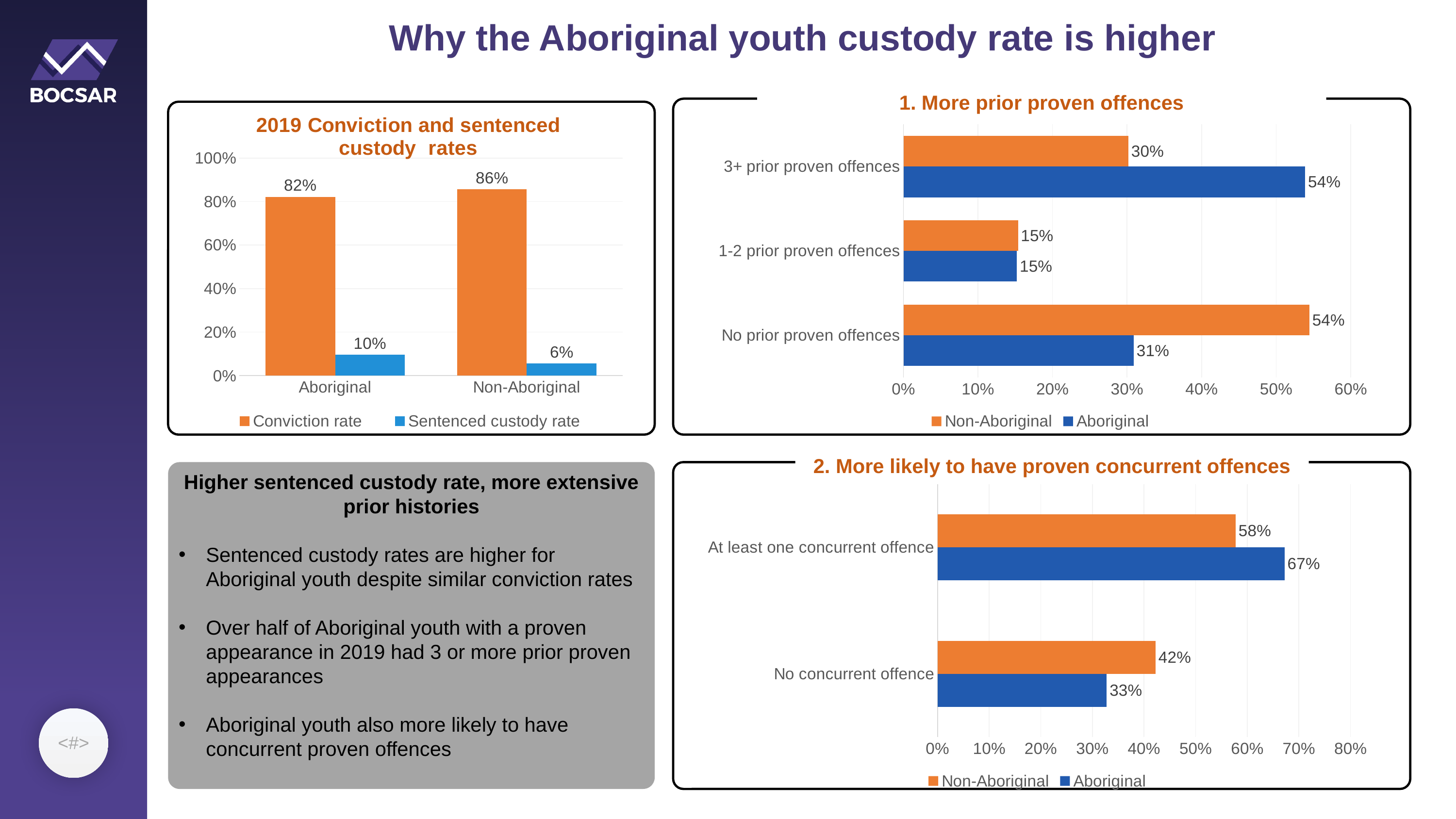
In the '1. More prior proven offences' chart, what is the Non-Aboriginal value for No prior proven offences? 54% In the '1. More prior proven offences' chart, what is the Aboriginal value for 3+ prior proven offences? 54% In the '2019 Conviction and sentenced custody rates' chart, what is the sentenced custody rate for Non-Aboriginal youth? 6% In the '2019 Conviction and sentenced custody rates' chart, what is the conviction rate for Aboriginal youth? 82% In the '2. More likely to have proven concurrent offences' chart, what is the difference between the Non-Aboriginal and Aboriginal values for No concurrent offence? 9% In the '2. More likely to have proven concurrent offences' chart, what is the Aboriginal value for At least one concurrent offence? 67% In the '2. More likely to have proven concurrent offences' chart, which colour represents Non-Aboriginal? Orange In the '1. More prior proven offences' chart, which group has the larger value for 3+ prior proven offences, Aboriginal or Non-Aboriginal? Aboriginal In the '2019 Conviction and sentenced custody rates' chart, what is the difference between the Aboriginal and Non-Aboriginal sentenced custody rates? 4% In the '2019 Conviction and sentenced custody rates' chart, how many series does the legend list? 2 What kind of chart is '2. More likely to have proven concurrent offences'? Bar chart In the '1. More prior proven offences' chart, how many categories are shown on the vertical axis? 3